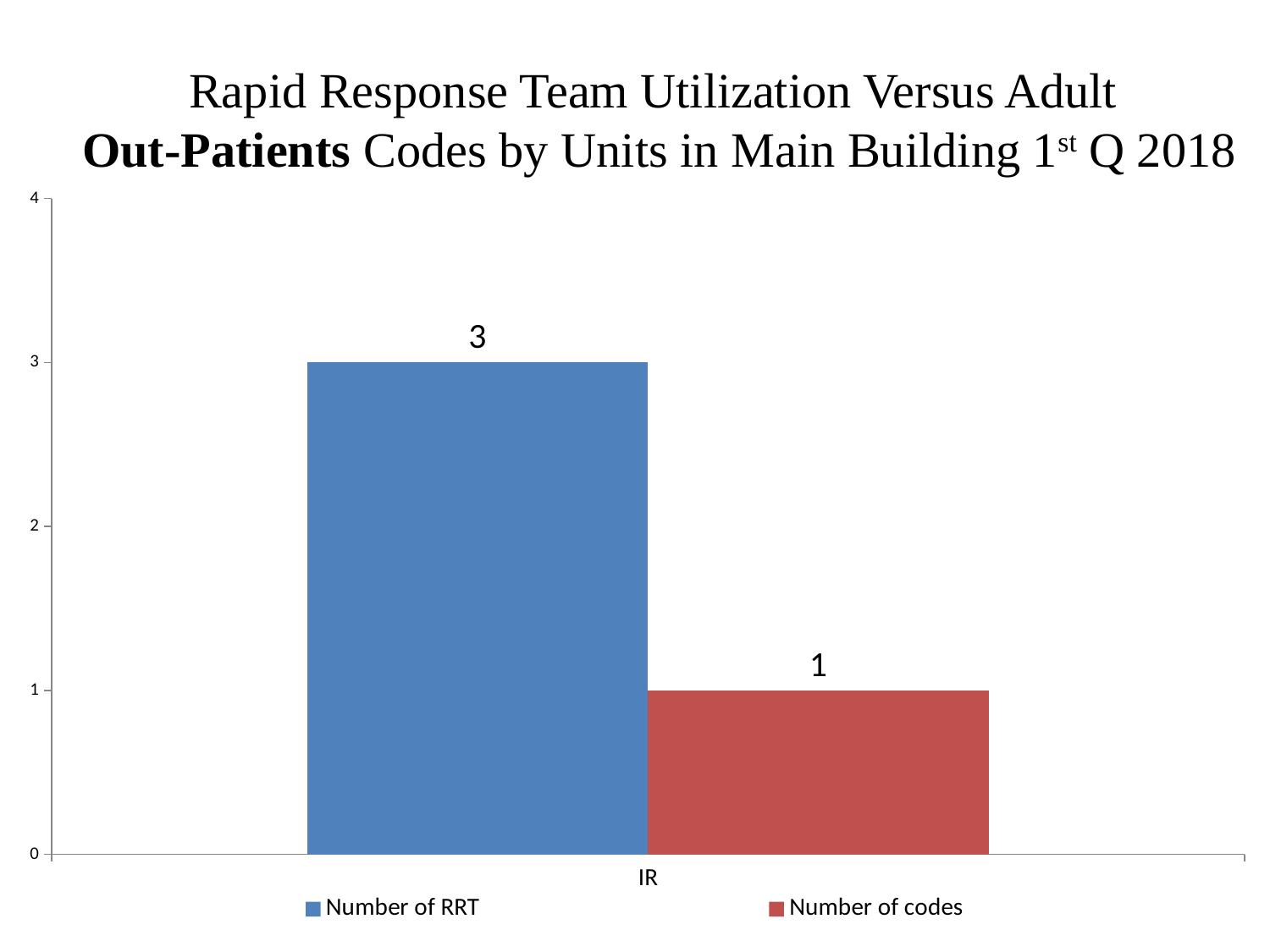
Is the value of Number of codes for IR greater or less than 2? less What kind of chart is shown on the slide? Bar chart What is the value of Number of RRT for IR? 3 Is the value of Number of RRT for IR greater or less than 2? greater How many categories are shown on the x axis? 1 What is the name of the category shown on the x axis? IR How many series does the legend list? 2 What is the value of Number of codes for IR? 1 Which series is shown in red? Number of codes What is the difference between Number of RRT and Number of codes for IR? 2 Which series has the higher value for IR, Number of RRT or Number of codes? Number of RRT What is the maximum value shown on the y axis? 4